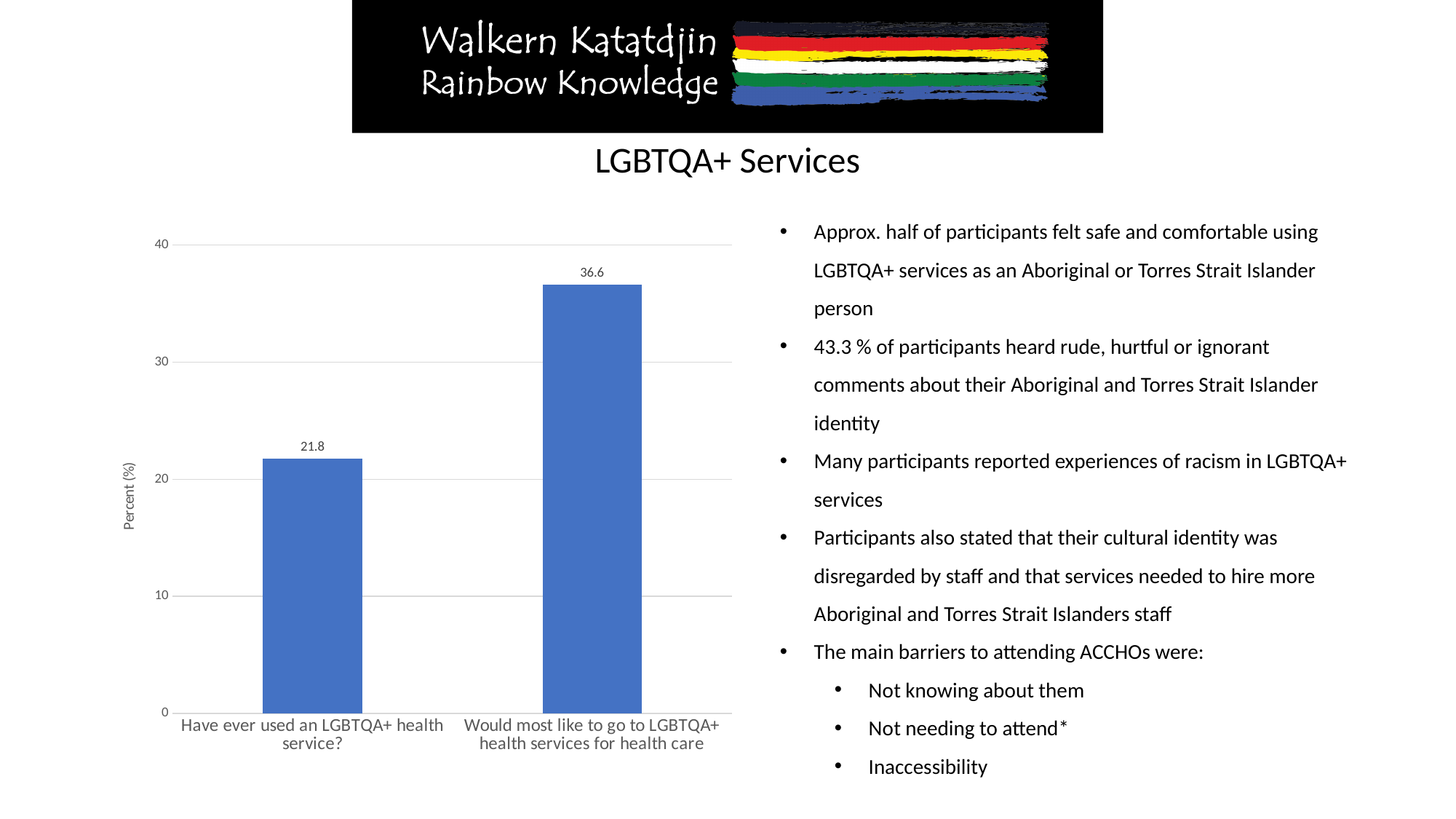
What is the value for "Would most like to go to LGBTQA+ health services for health care"? 36.6 What kind of chart is shown on the slide? Bar chart Is the value for "Have ever used an LGBTQA+ health service?" greater or less than 30? less Which category has the highest value? Would most like to go to LGBTQA+ health services for health care How many categories are shown in the chart? 2 Is the value for "Would most like to go to LGBTQA+ health services for health care" greater or less than 30? greater What is the difference between the values for "Would most like to go to LGBTQA+ health services for health care" and "Have ever used an LGBTQA+ health service?"? 14.8 Which category has the lowest value? Have ever used an LGBTQA+ health service? What is the value for "Have ever used an LGBTQA+ health service?"? 21.8 What is the label of the vertical axis of the chart? Percent (%) What is the maximum value shown on the vertical axis of the chart? 40 Which is larger: the value for "Have ever used an LGBTQA+ health service?" or the value for "Would most like to go to LGBTQA+ health services for health care"? Would most like to go to LGBTQA+ health services for health care